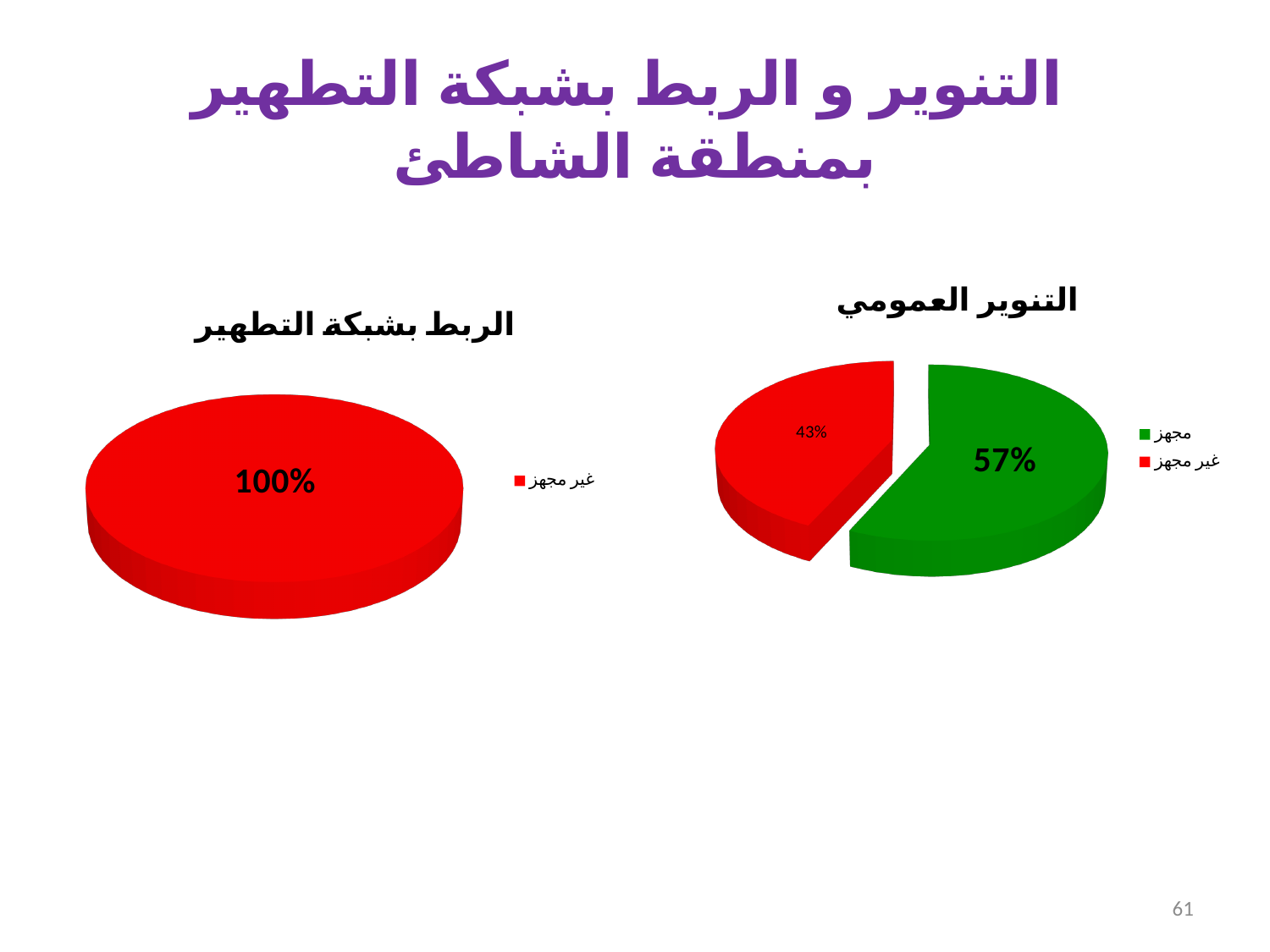
How many entries does the legend of the chart titled "التنوير العمومي" list? 2 In the chart titled "التنوير العمومي", which category has the largest slice? مجهز In the chart titled "التنوير العمومي", which category has the smallest slice? غير مجهز How many entries does the legend of the chart titled "الربط بشبكة التطهير" list? 1 In the chart titled "التنوير العمومي", what is the value for "مجهز"? 57% What kind of chart is the chart titled "التنوير العمومي" on the right of the slide? Pie chart In the chart titled "الربط بشبكة التطهير" on the left, what is the value for "غير مجهز"? 100% How many slices does the chart titled "التنوير العمومي" have? 2 In the chart titled "التنوير العمومي", which is larger: "مجهز" or "غير مجهز"? مجهز In the chart titled "التنوير العمومي", what is the value for "غير مجهز"? 43% In the chart titled "التنوير العمومي", what colour is the "مجهز" slice? Green In the chart titled "التنوير العمومي", what is the difference between the "مجهز" and "غير مجهز" slices? 14%